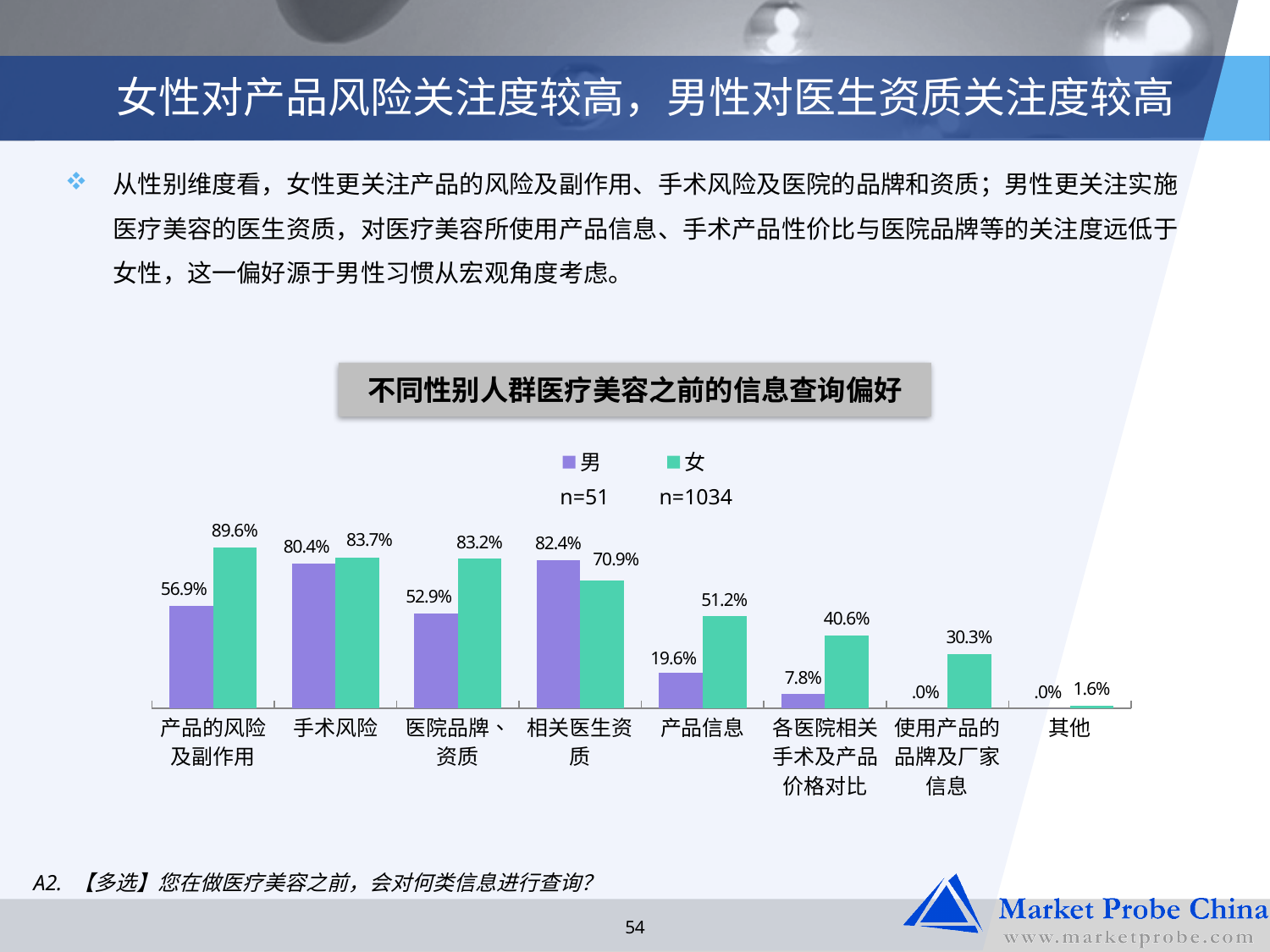
What is the value for 女 in the 各医院相关手术及产品价格对比 category? 40.6% What is the sample size (n) for the 女 series shown in the legend? n=1034 How many categories are shown on the x axis? 8 What type of chart is shown on the slide? bar chart What is the difference between the 女 and 男 values in the 产品信息 category? 31.6% What is the value for 女 in the 产品的风险及副作用 category? 89.6% How many series does the legend list? 2 Which category has the lowest value for 女? 其他 In the 相关医生资质 category, which series has the larger value, 男 or 女? 男 Which category has the highest value for 男? 相关医生资质 What is the title of the chart? 不同性别人群医疗美容之前的信息查询偏好 What is the value for 男 in the 相关医生资质 category? 82.4%